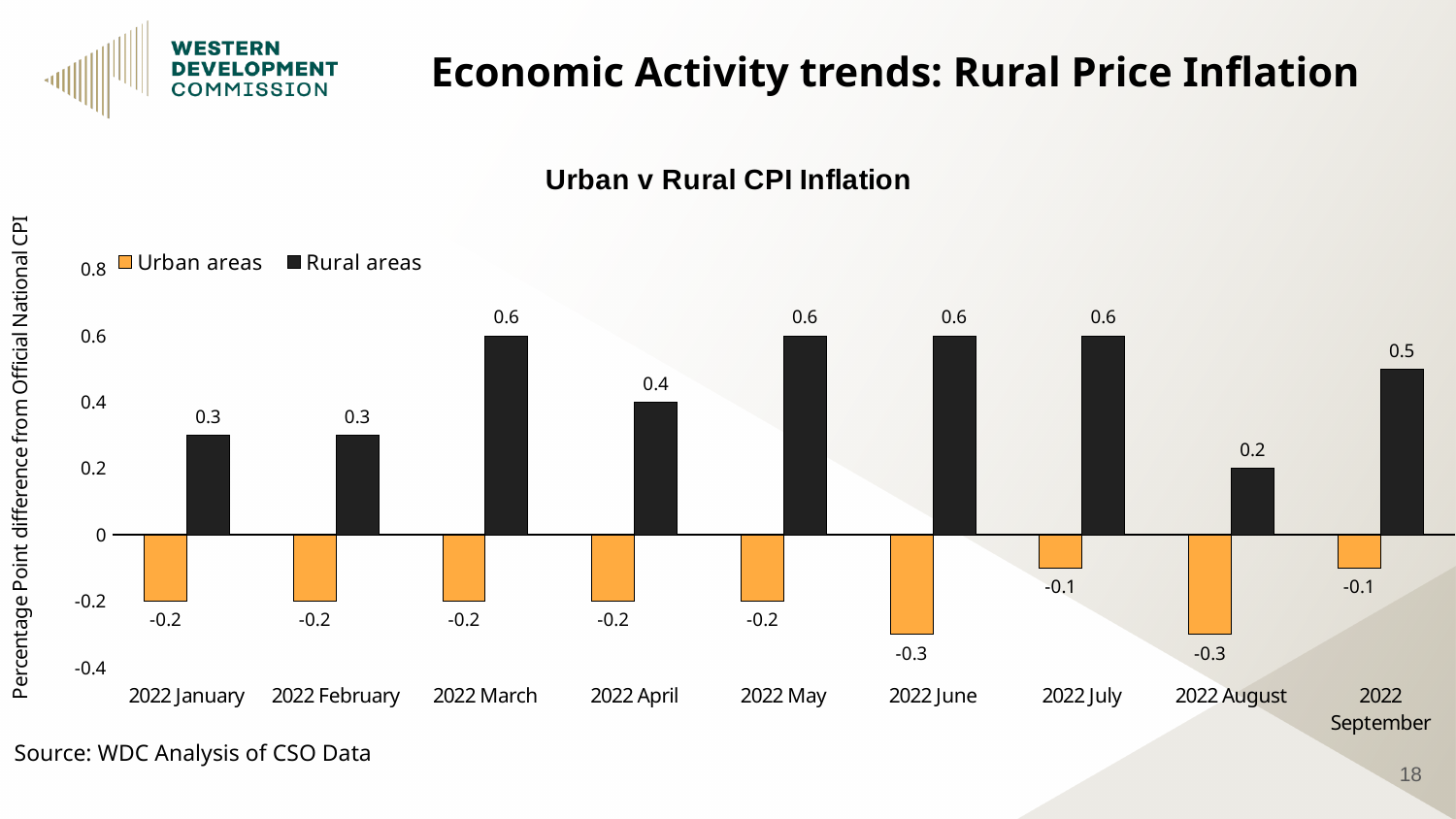
How many months are shown on the x axis? 9 What kind of chart is shown? Bar chart What is the value for Rural areas in 2022 September? 0.5 How many series does the legend list? 2 Which colour represents Urban areas in the chart? Orange Which is larger, the Rural areas value for 2022 April or for 2022 August? 2022 April What is the value for Urban areas in 2022 June? -0.3 What is the value for Urban areas in 2022 July? -0.1 What is the value for Rural areas in 2022 March? 0.6 Which month has the lowest value for Rural areas? 2022 August What is the difference between the Rural areas values for 2022 March and 2022 January? 0.3 What is the title of the chart? Urban v Rural CPI Inflation